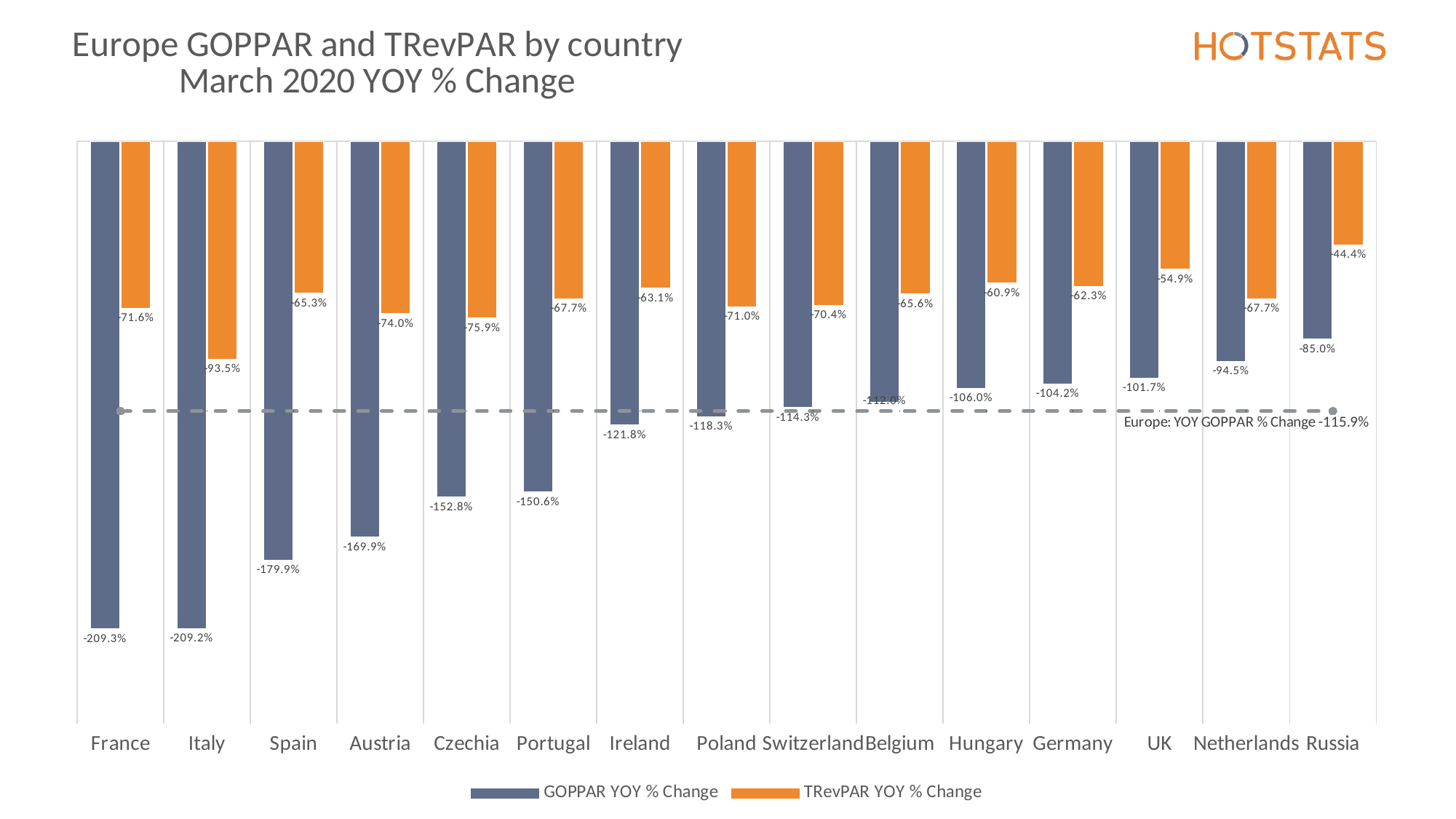
What is the TRevPAR YOY % Change for the UK? -54.9% Which country has the highest (least negative) GOPPAR YOY % Change? Russia How many countries are shown on the x axis? 15 What is the difference between Russia's GOPPAR YOY % Change and its TRevPAR YOY % Change? 40.6 percentage points Which country has the lowest (most negative) TRevPAR YOY % Change? Italy Which is larger, the TRevPAR YOY % Change for Ireland or for Poland? Ireland What is the GOPPAR YOY % Change for Spain? -179.9% How many series does the legend list? 2 What value does the dashed line for Europe YOY GOPPAR % Change show? -115.9% What is the GOPPAR YOY % Change for Switzerland? -114.3% What kind of chart is shown on the slide? Bar chart What is the TRevPAR YOY % Change for Italy? -93.5%